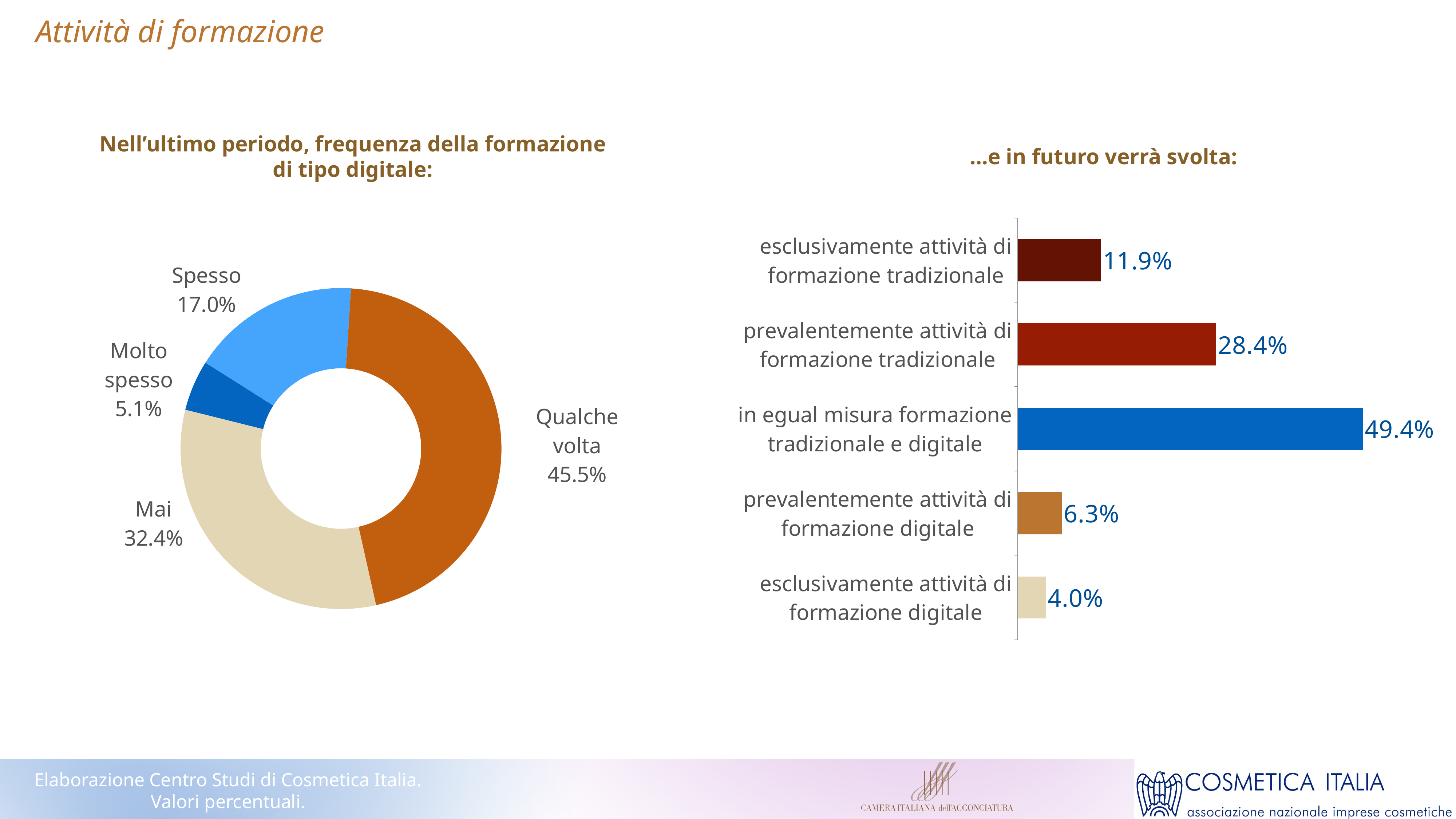
In the left chart (frequenza della formazione di tipo digitale), what is the value for 'Qualche volta'? 45.5% What kind of chart is the left chart (frequenza della formazione di tipo digitale)? Doughnut chart What kind of chart is the right chart (...e in futuro verrà svolta)? Bar chart In the left chart (frequenza della formazione di tipo digitale), what is the difference between 'Mai' and 'Spesso'? 15.4% In the right chart (...e in futuro verrà svolta), which category has the highest value? in egual misura formazione tradizionale e digitale In the left chart (frequenza della formazione di tipo digitale), how many categories are shown? 4 In the right chart (...e in futuro verrà svolta), what is the difference between 'esclusivamente attività di formazione tradizionale' and 'prevalentemente attività di formazione digitale'? 5.6% In the left chart (frequenza della formazione di tipo digitale), which category has the largest share? Qualche volta In the left chart (frequenza della formazione di tipo digitale), which category has the smallest share? Molto spesso In the right chart (...e in futuro verrà svolta), what is the value for 'prevalentemente attività di formazione tradizionale'? 28.4% In the left chart (frequenza della formazione di tipo digitale), what is the value for 'Molto spesso'? 5.1% In the right chart (...e in futuro verrà svolta), which category has the lowest value? esclusivamente attività di formazione digitale